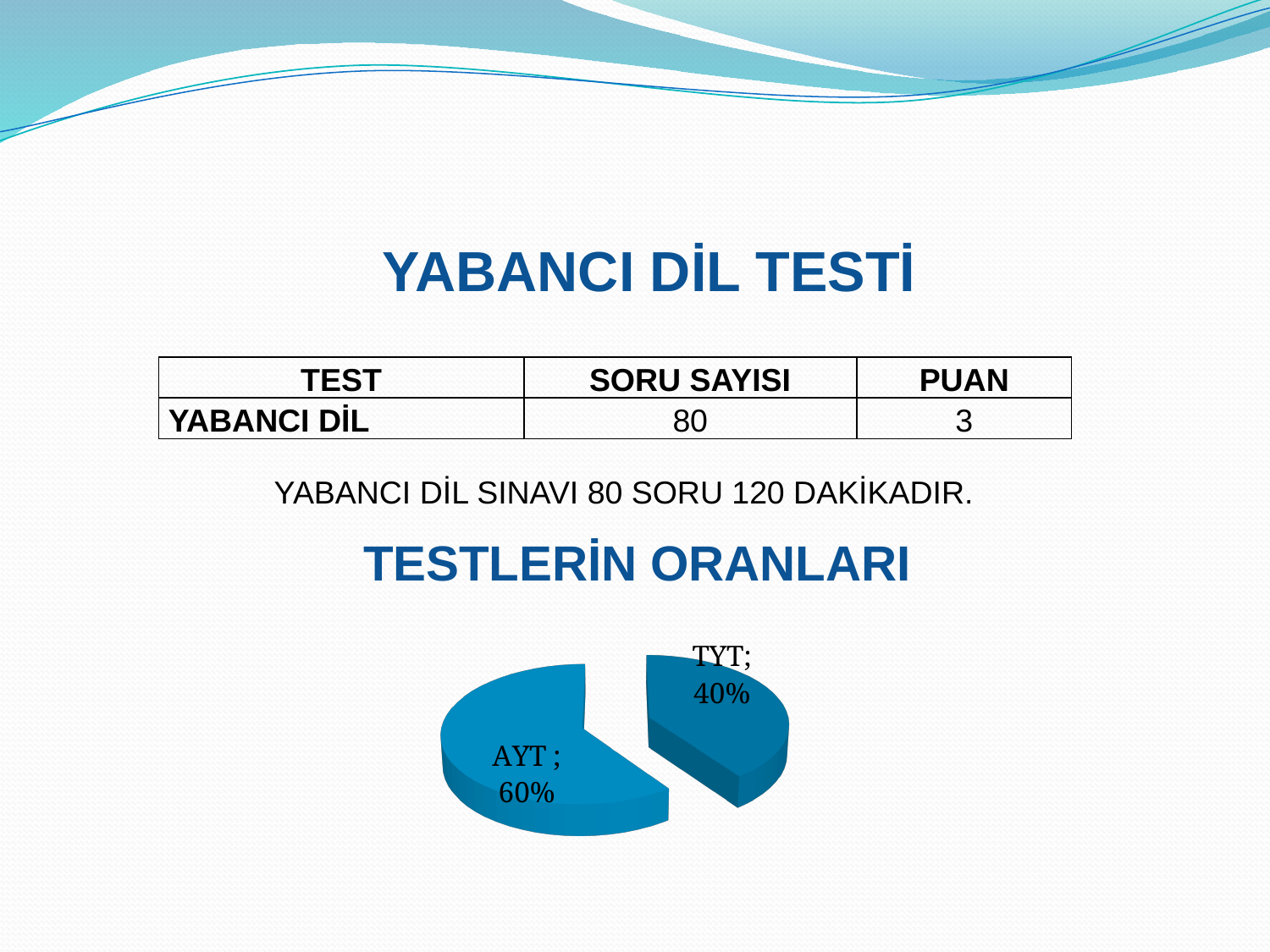
What is the total of the two slices shown in the pie chart? 100% How many slices does the pie chart have? 2 What kind of chart is shown under the heading TESTLERİN ORANLARI? pie chart Which slice of the pie chart is the smallest? TYT What is the difference in percentage points between the AYT and TYT slices? 20% What share of the pie chart does TYT have? 40% What heading appears directly above the pie chart? TESTLERİN ORANLARI Is the pie chart drawn with a 3-D effect? yes Which slice of the pie chart is the largest? AYT Which is larger in the pie chart, AYT or TYT? AYT What share of the pie chart does AYT have? 60%